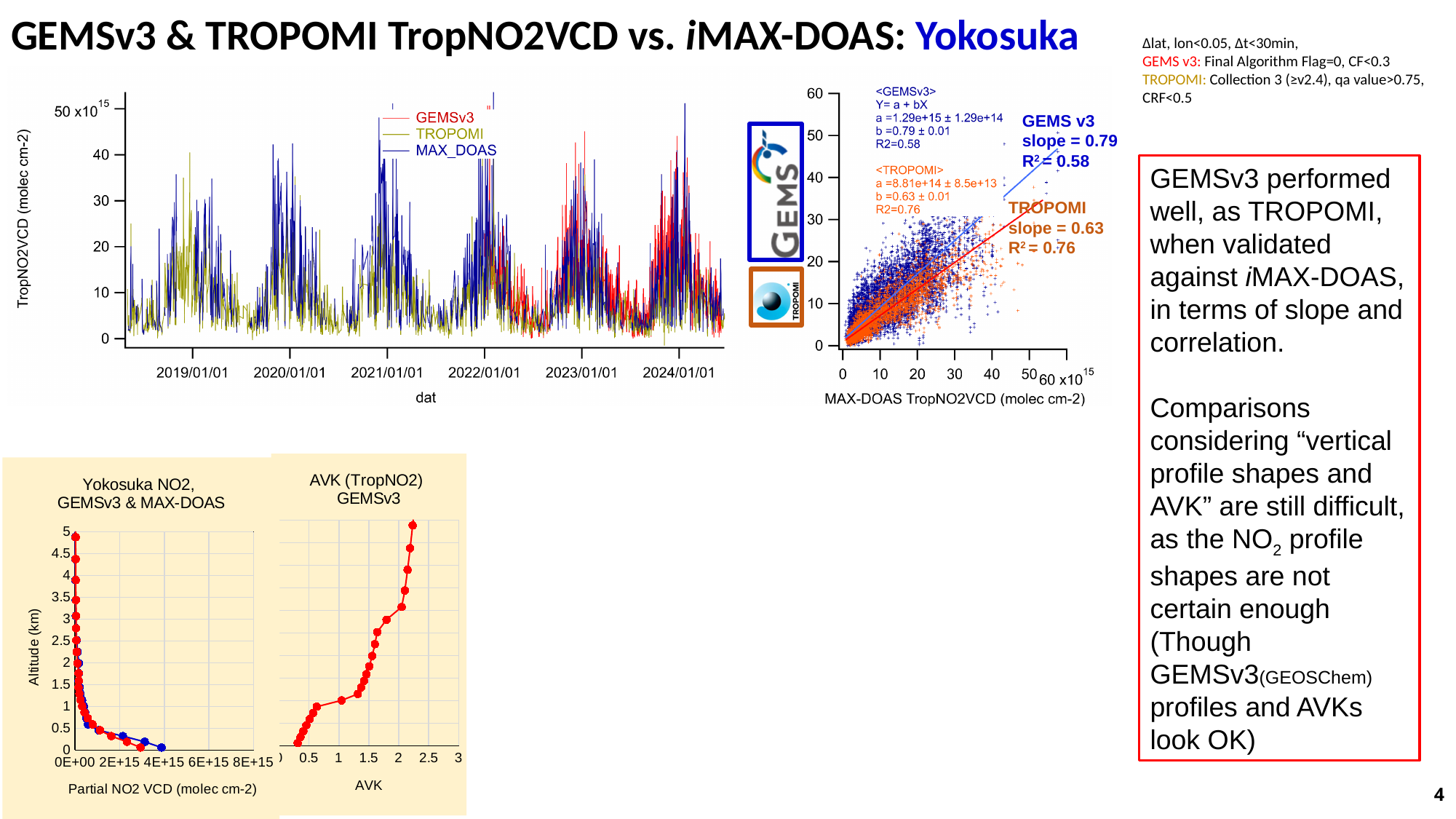
In the scatter plot against MAX-DOAS, which has the larger slope, GEMS v3 or TROPOMI? GEMS v3 In the scatter plot against MAX-DOAS, what is the difference between the GEMS v3 slope and the TROPOMI slope? 0.16 In the 'Yokosuka NO2, GEMSv3 & MAX-DOAS' chart, does the partial NO2 VCD rise or fall as altitude increases? fall What kind of chart is the top-middle chart plotting satellite TropNO2VCD against MAX-DOAS TropNO2VCD? scatter plot In the top-left time series chart, what are the three series named in the legend? GEMSv3, TROPOMI, MAX_DOAS In the top-left time series chart, how many series does the legend list? 3 In the scatter plot against MAX-DOAS, which has the higher R², GEMS v3 or TROPOMI? TROPOMI In the scatter plot against MAX-DOAS, what is the slope reported for GEMS v3? 0.79 What is the y-axis label of the top-left time series chart? TropNO2VCD (molec cm-2) In the 'AVK (TropNO2) GEMSv3' chart, is the AVK at 5 km altitude greater or less than 2? greater In the 'AVK (TropNO2) GEMSv3' chart, is the AVK at 0 km altitude greater or less than 0.5? less In the scatter plot against MAX-DOAS, what is the R² reported for TROPOMI? 0.76